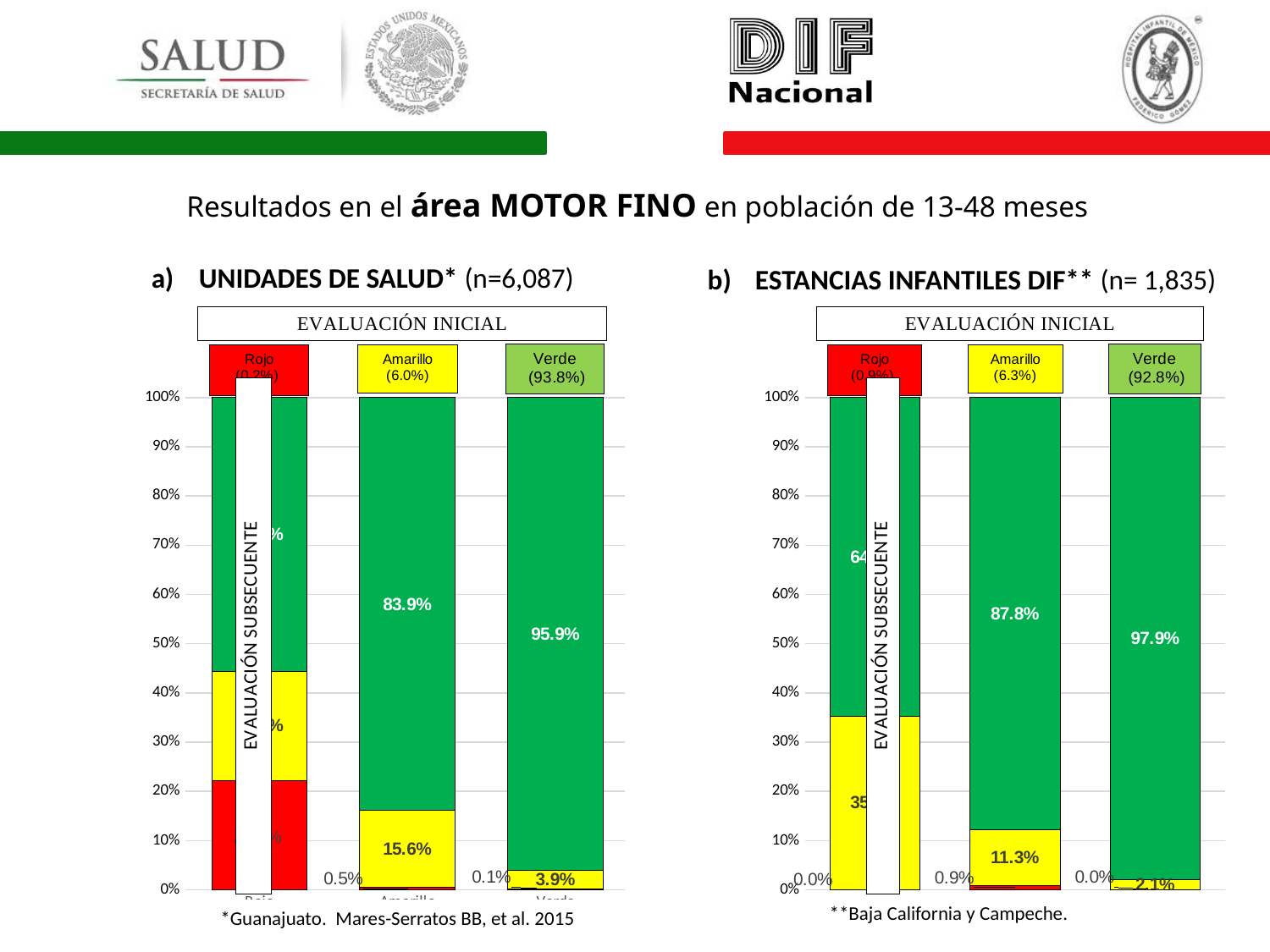
In chart b) ESTANCIAS INFANTILES DIF, what is the yellow (Amarillo) share in the subsequent evaluation for the Verde initial group? 2.1% How many initial evaluation categories (bars) are shown in chart b) ESTANCIAS INFANTILES DIF? 3 In chart a) UNIDADES DE SALUD, what is the red share in the subsequent evaluation for the Verde initial group? 0.1% In chart b) ESTANCIAS INFANTILES DIF, what is the green share in the subsequent evaluation for the Verde initial group? 97.9% In chart b) ESTANCIAS INFANTILES DIF, is the green share in the subsequent evaluation for the Rojo initial group greater or less than 50%? greater What is the difference between the green share for the Amarillo initial group in chart b) ESTANCIAS INFANTILES DIF (87.8%) and in chart a) UNIDADES DE SALUD (83.9%)? 3.9% What kind of chart is used in chart a) UNIDADES DE SALUD? Stacked bar chart In chart b) ESTANCIAS INFANTILES DIF, what percentage of the initial evaluation was Amarillo? 6.3% Which chart shows a higher green share in the subsequent evaluation for the Amarillo initial group, chart a) UNIDADES DE SALUD or chart b) ESTANCIAS INFANTILES DIF? Chart b) ESTANCIAS INFANTILES DIF In chart a) UNIDADES DE SALUD, what is the green (Verde) share in the subsequent evaluation for the Amarillo initial group? 83.9% In chart a) UNIDADES DE SALUD, what percentage of the initial evaluation was Verde? 93.8% In chart a) UNIDADES DE SALUD, which initial evaluation category has the lowest percentage? Rojo (0.2%)